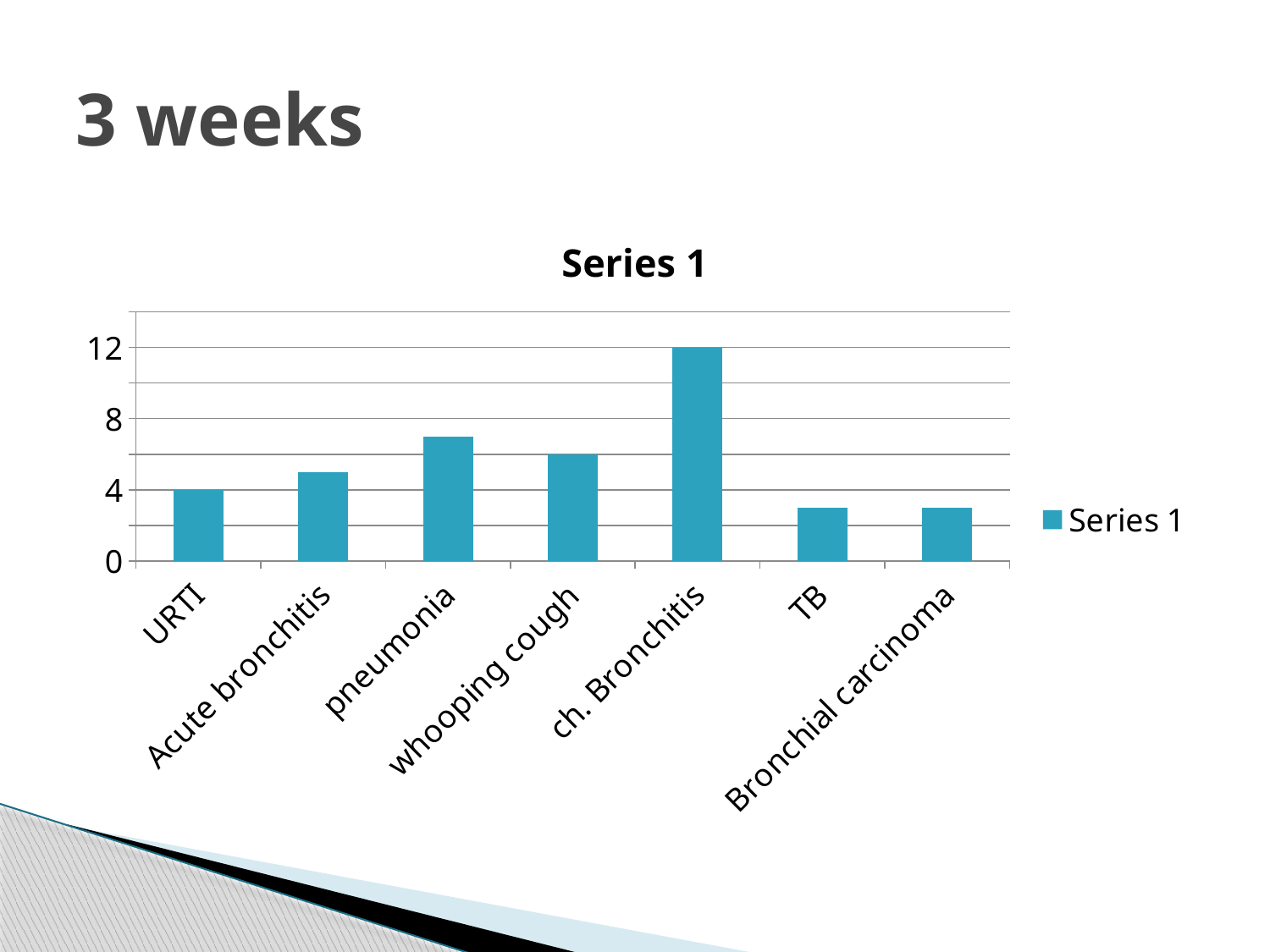
What is the title of the chart? Series 1 How many categories are shown on the x axis of the chart? 7 How many series does the legend list? 1 Is the value for Acute bronchitis greater or less than 4? greater What is the value for URTI? 4 Is the value for TB greater or less than 4? less What type of chart is shown on the slide? bar chart What is the value for ch. Bronchitis? 12 Which is larger, the value for pneumonia or the value for whooping cough? pneumonia Is the value for pneumonia greater or less than 8? less Which category has the highest value in the chart? ch. Bronchitis Which is larger, the value for ch. Bronchitis or the value for Bronchial carcinoma? ch. Bronchitis